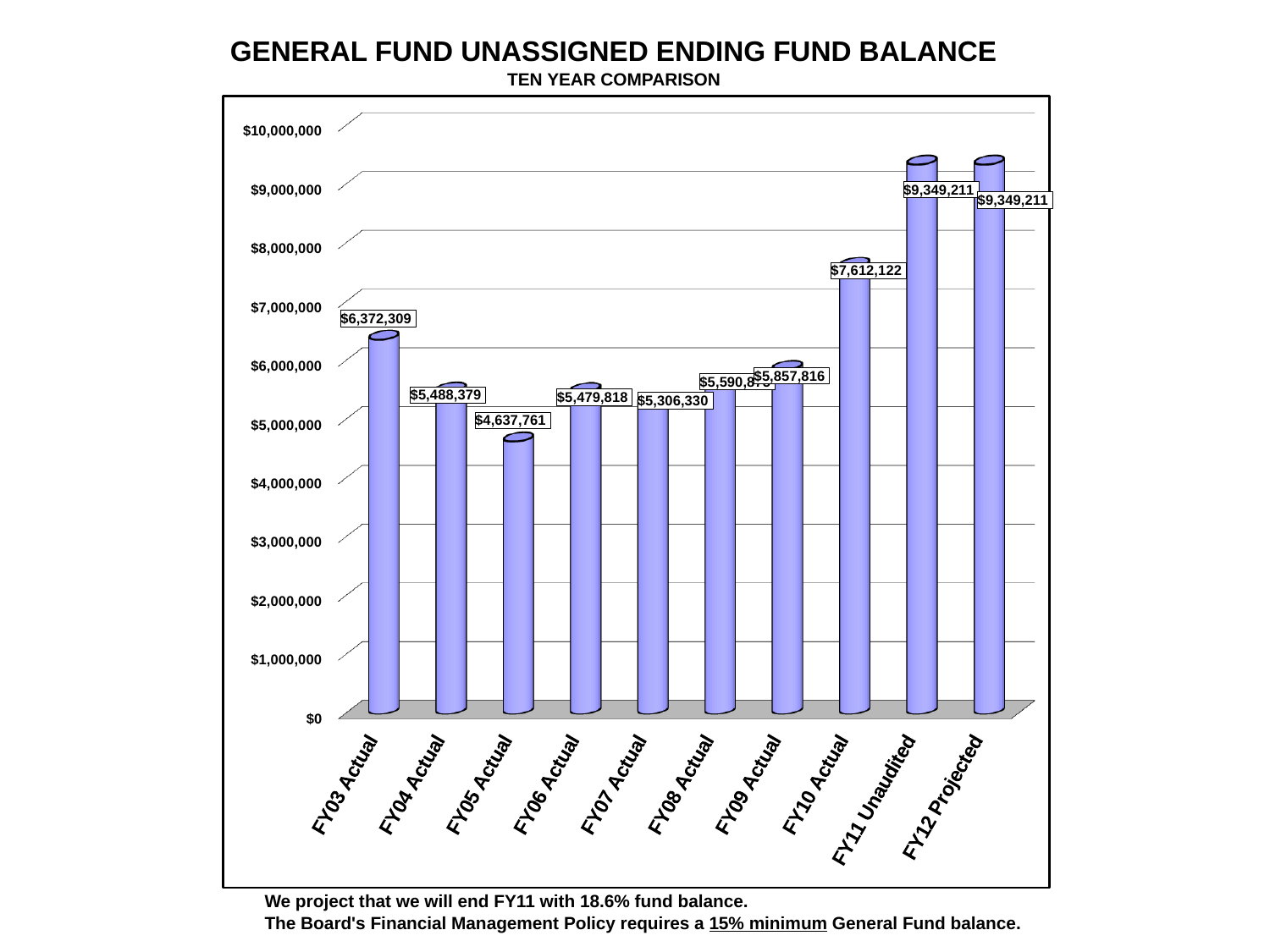
How many fiscal years are shown on the chart? 10 What is the difference between the FY10 Actual and FY03 Actual values? $1,239,813 What is the value for FY12 Projected? $9,349,211 What is the value for FY05 Actual? $4,637,761 What kind of chart is shown on the slide? bar chart Which is larger, the value for FY09 Actual or FY07 Actual? FY09 Actual Which fiscal year has the lowest unassigned ending fund balance? FY05 Actual Do the values rise or fall from FY09 Actual to FY12 Projected? rise What is the value for FY10 Actual? $7,612,122 What is the value for FY03 Actual? $6,372,309 What is the difference between the FY11 Unaudited and FY10 Actual values? $1,737,089 Is the value for FY08 Actual greater or less than $6,000,000? less